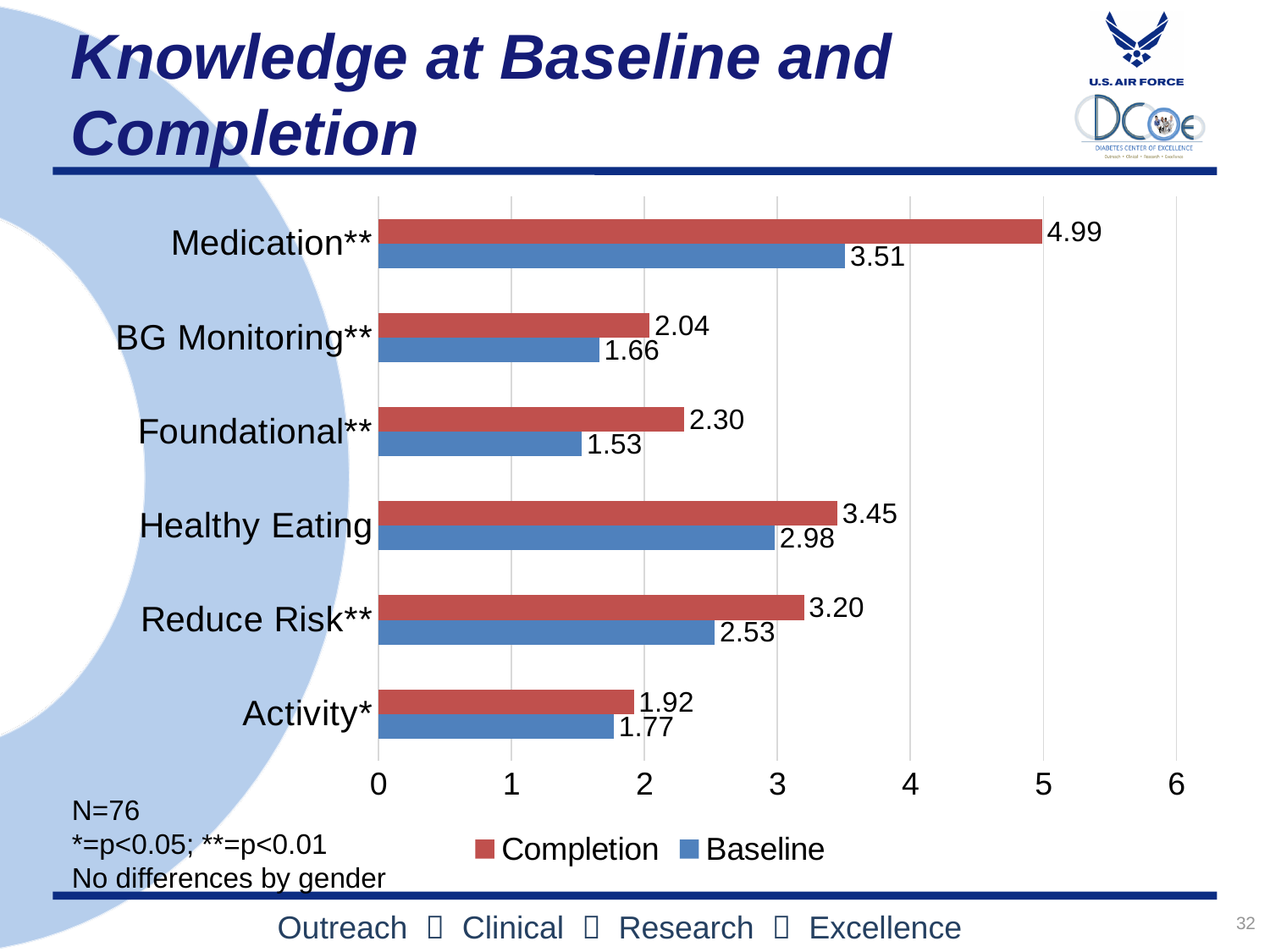
What is the difference between the Completion and Baseline values for Reduce Risk**? 0.67 Is the Baseline value for Medication** greater or less than 3? greater How many series does the legend list? 2 Which category has the lowest Baseline value? Foundational** What is the Completion value for Medication**? 4.99 What is the sample size (N) stated on the slide? N=76 Which category has the highest Completion value? Medication** What is the Baseline value for Foundational**? 1.53 Which is larger, the Completion value for BG Monitoring** or the Completion value for Foundational**? Foundational** What kind of chart is shown on the slide? bar chart What is the Baseline value for Healthy Eating? 2.98 How many categories are shown on the chart? 6